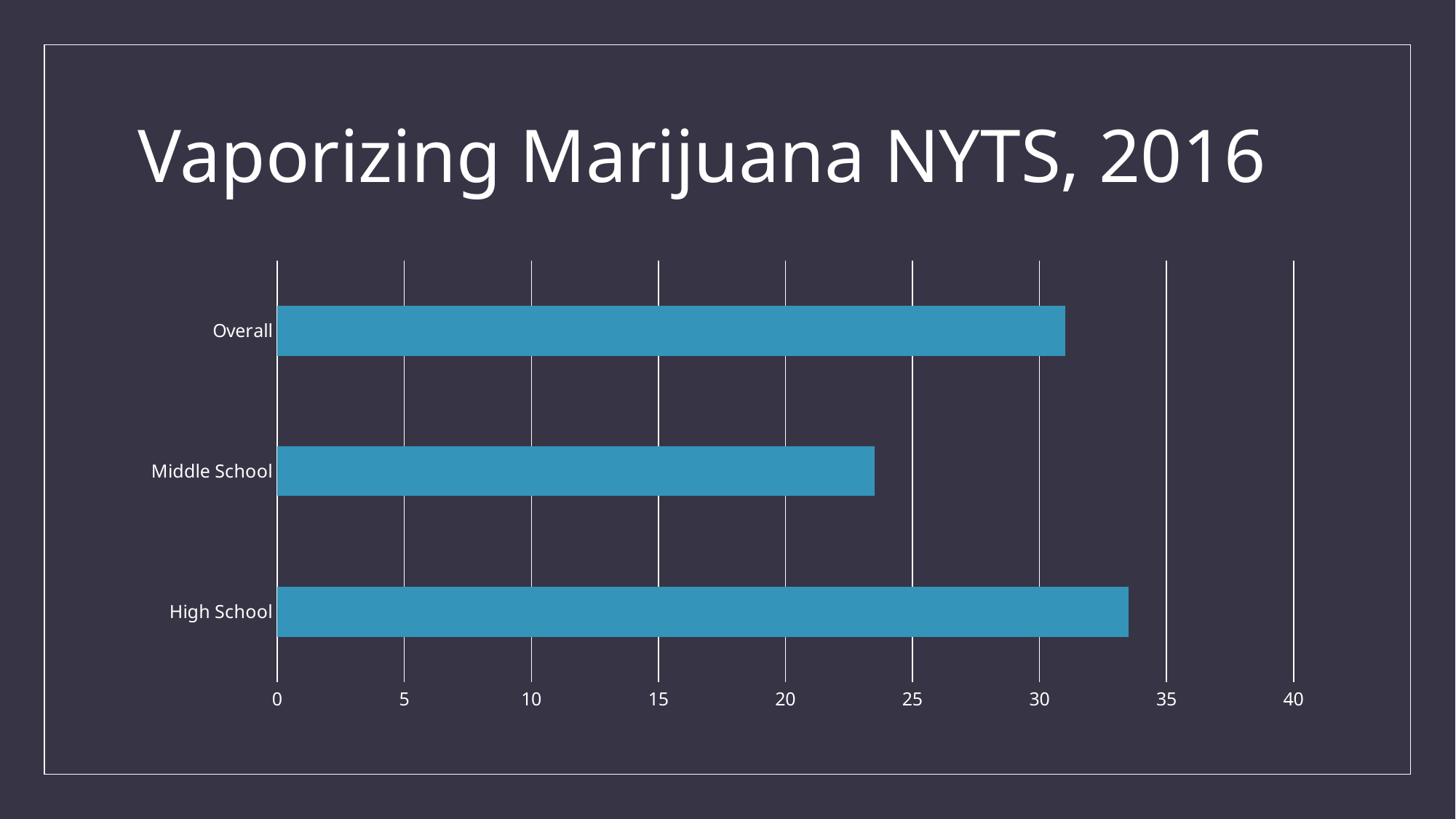
What is the title of the chart? Vaporizing Marijuana NYTS, 2016 Which is larger, the value for High School or the value for Middle School? High School Which is larger, the value for Overall or the value for Middle School? Overall What is the highest value shown on the horizontal axis? 40 How many categories are plotted in the chart? 3 Which category has the lowest value? Middle School Is the value for Middle School greater or less than 25? less Which category has the highest value? High School What kind of chart is shown on the slide? bar chart Is the value for High School greater or less than 35? less Is the value for High School greater or less than 30? greater